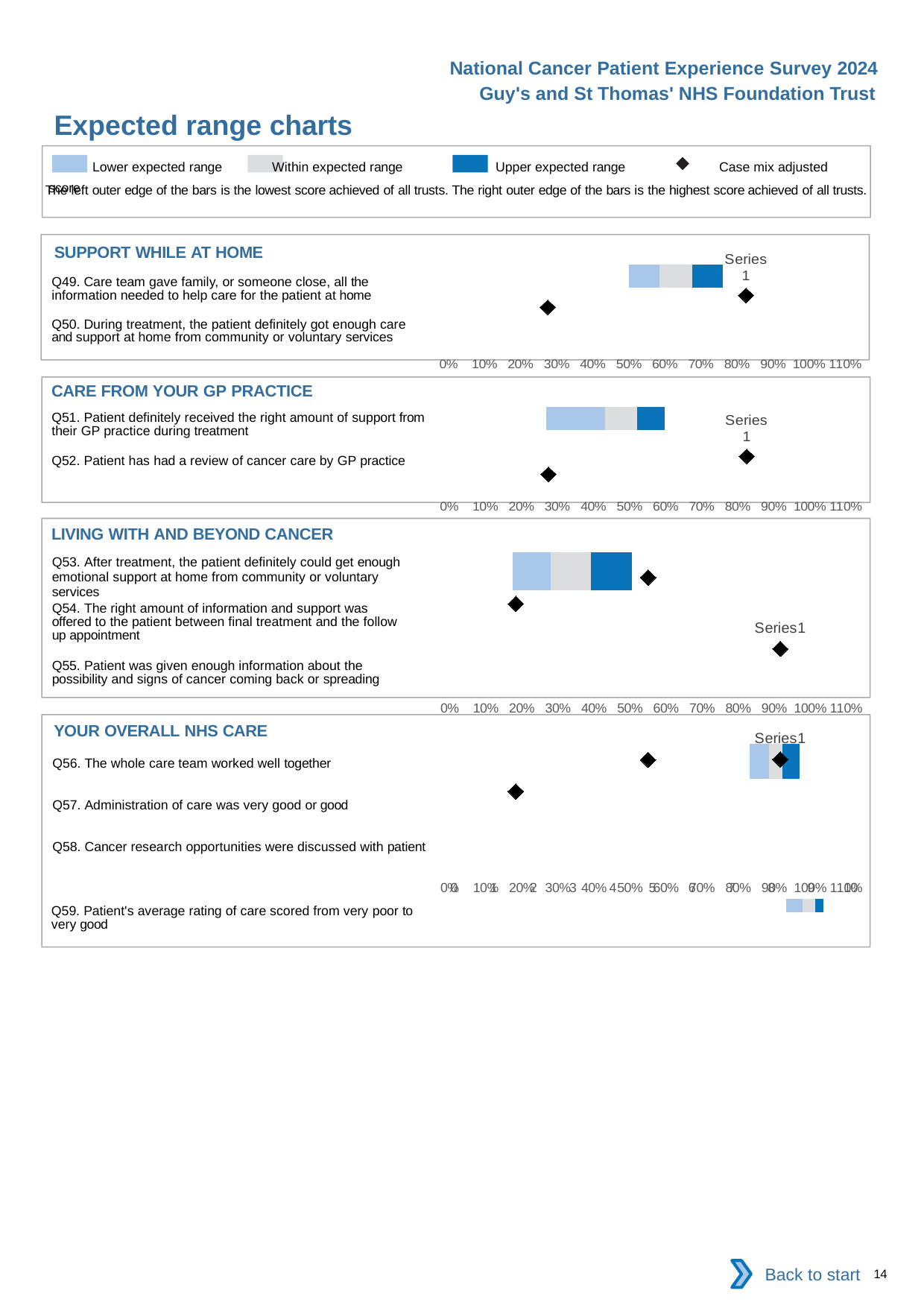
According to the legend, what does the black diamond marker represent? Case mix adjusted score What is the highest tick label on the x axis of the SUPPORT WHILE AT HOME chart? 110% How many entries does the legend at the top of the slide list? 4 In the CARE FROM YOUR GP PRACTICE chart, is the diamond directly below the "Series 1" label greater or less than 70%? greater How many section charts are shown on the slide? 4 What kind of chart is used in the SUPPORT WHILE AT HOME section? Bar chart How many questions are listed in the LIVING WITH AND BEYOND CANCER chart? 3 How many questions are listed in the YOUR OVERALL NHS CARE chart? 4 In the LIVING WITH AND BEYOND CANCER chart, is the diamond immediately to the right of the Q53 bar greater or less than 40%? greater In the SUPPORT WHILE AT HOME chart, is the diamond directly below the "Series 1" label greater or less than 70%? greater